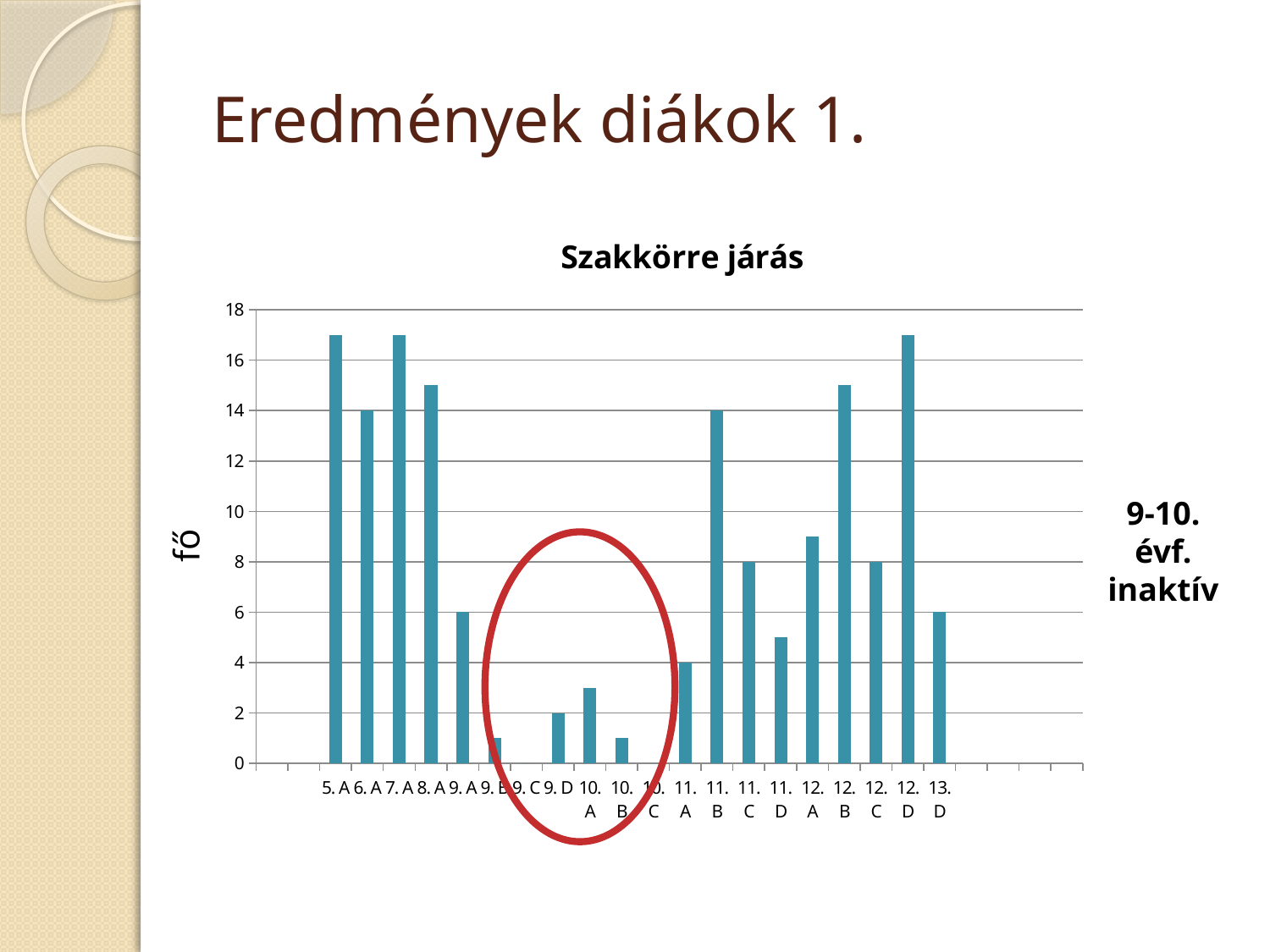
What is the difference between the values for 6. A and 9. A? 8 Which has a larger value, 8. A or 9. A? 8. A What is the value for 11. C in the chart? 8 What is the title of the chart? Szakkörre járás What is the value for 6. A in the chart? 14 What is the value for 9. A in the chart? 6 What kind of chart is shown on the slide? bar chart Is the value for 12. A greater or less than 10? less Is the value for 12. B greater or less than 10? greater What is the value for 11. A in the chart? 4 How many classes (categories) are shown on the x axis of the chart? 20 What is the label on the vertical axis of the chart? fő